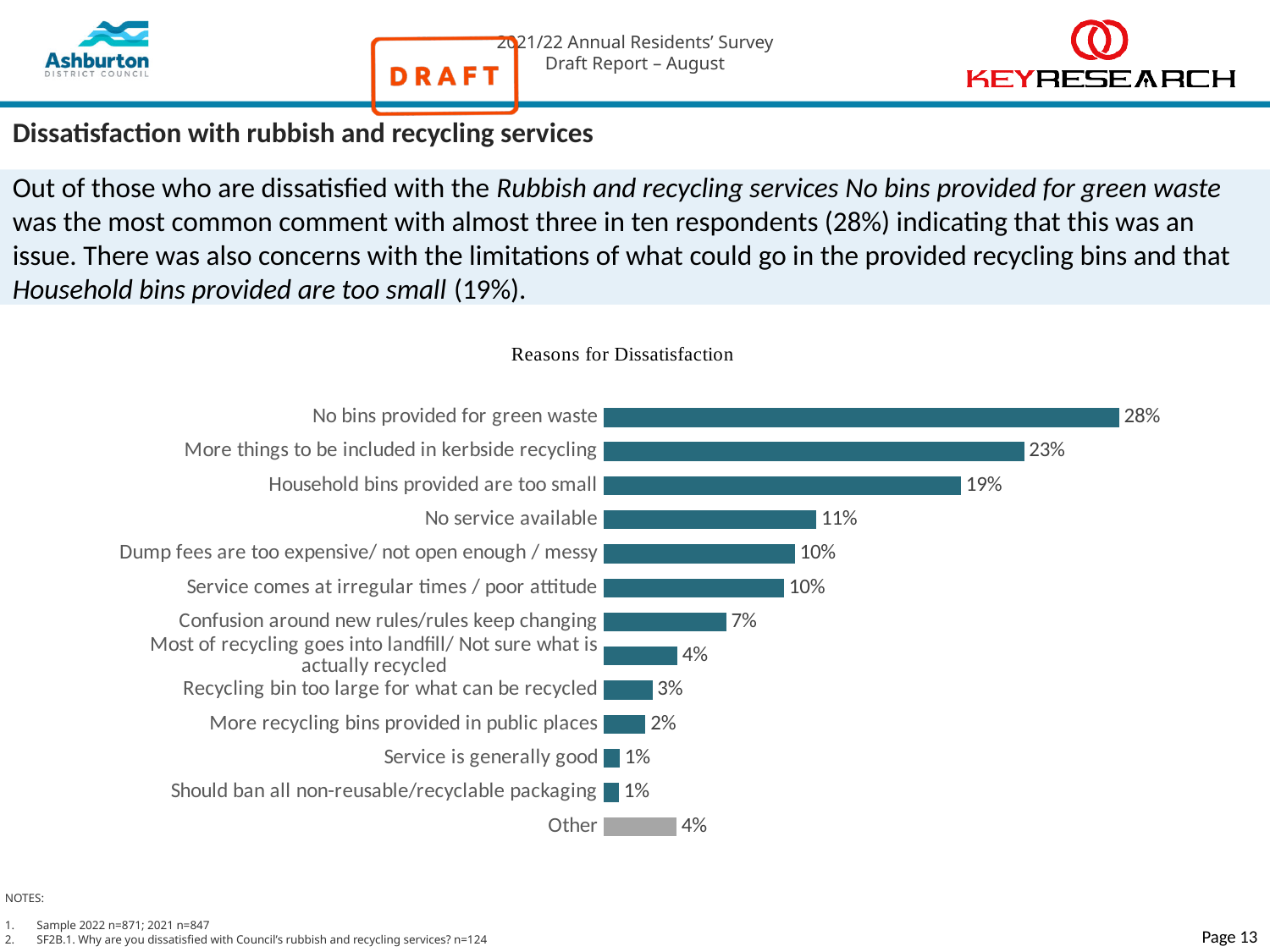
What is the title of the chart? Reasons for Dissatisfaction Which is larger: 'More things to be included in kerbside recycling' or 'Household bins provided are too small'? More things to be included in kerbside recycling What kind of chart is shown on the slide? Bar chart What is the value for 'No bins provided for green waste' in the Reasons for Dissatisfaction chart? 28% What is the difference between 'No bins provided for green waste' and 'More things to be included in kerbside recycling'? 5% What is the value for 'Household bins provided are too small'? 19% What is the value for 'No service available'? 11% What is the value for 'Other'? 4% Which is larger: 'Confusion around new rules/rules keep changing' or 'Recycling bin too large for what can be recycled'? Confusion around new rules/rules keep changing Which reason has the highest value in the chart? No bins provided for green waste How many categories are shown in the Reasons for Dissatisfaction chart? 13 What is the difference between 'Household bins provided are too small' and 'No service available'? 8%